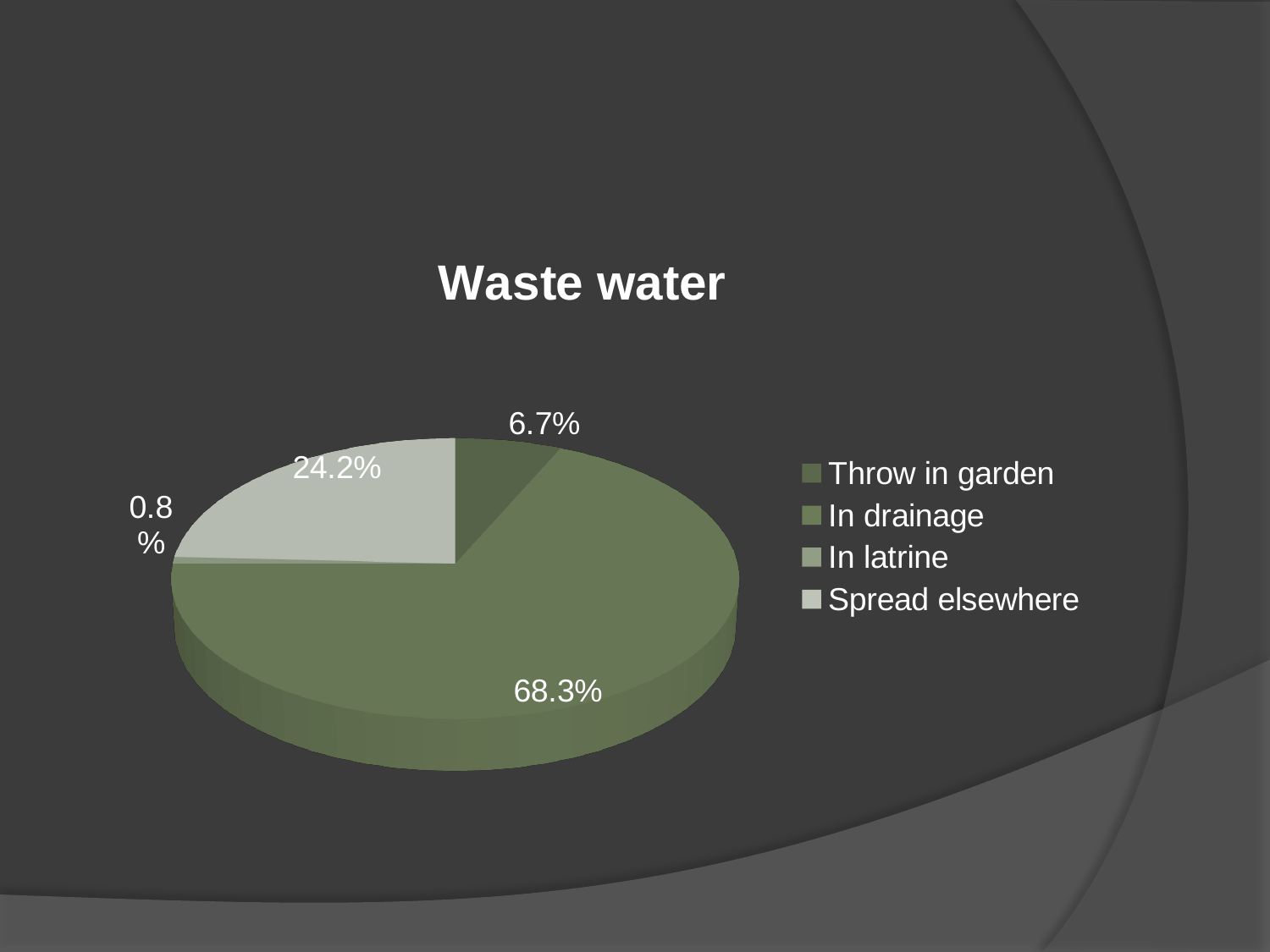
What is the title of the chart? Waste water What is the difference between the share for In drainage and the share for Spread elsewhere? 44.1% What type of chart is shown on the slide? Pie chart Which category has the smallest share of the pie? In latrine What percentage of waste water goes in drainage? 68.3% How many categories does the legend list? 4 What percentage of waste water is spread elsewhere? 24.2% Which legend entry is listed first? Throw in garden Which category has the largest share of the pie? In drainage What percentage of waste water goes in the latrine? 0.8% Which is larger, the share for Throw in garden or the share for Spread elsewhere? Spread elsewhere What percentage of waste water is thrown in the garden? 6.7%